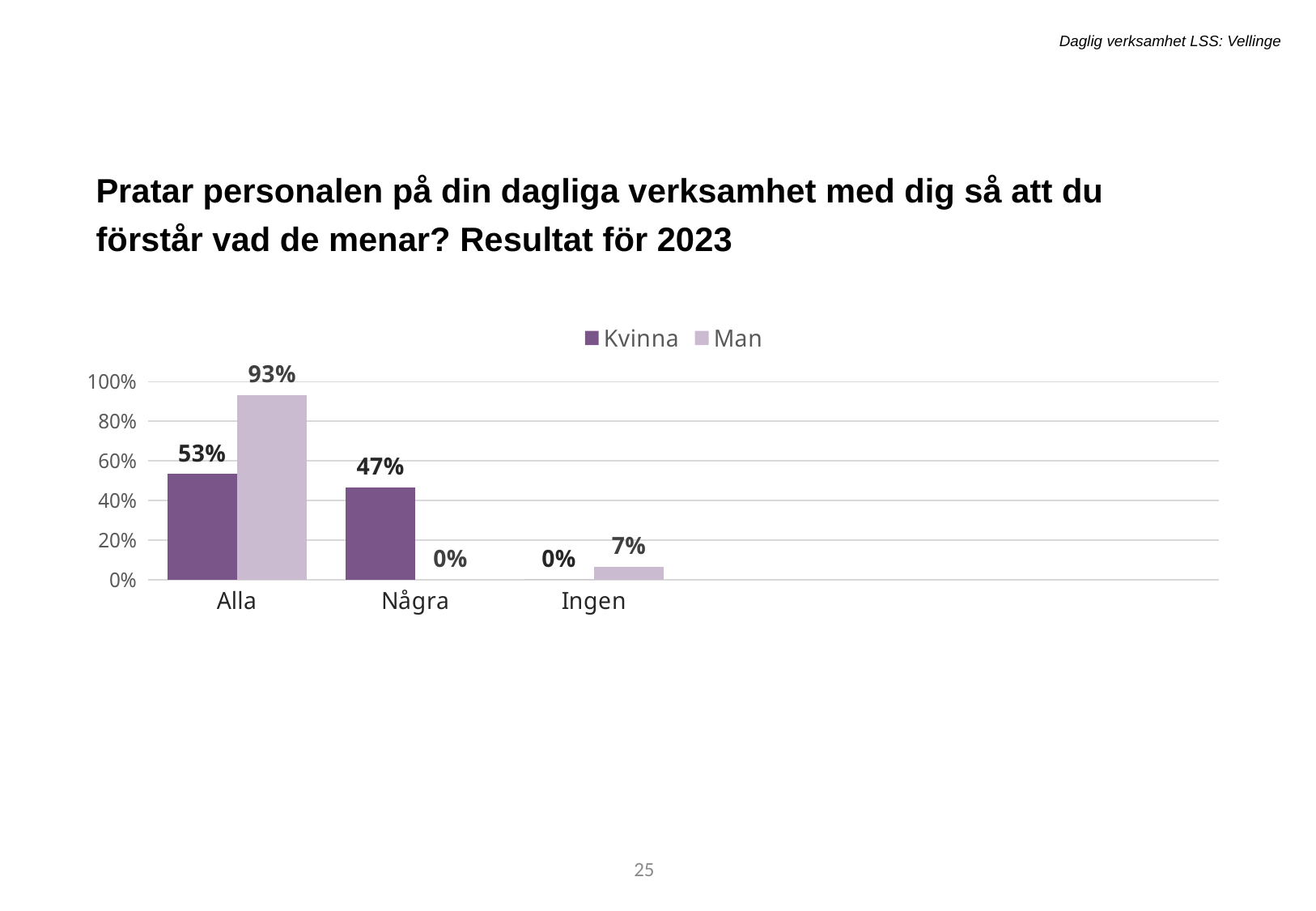
What is the difference between the Man and Kvinna values in the Alla category? 40% How many categories are shown on the x axis? 3 Which category has the highest value for the Man series? Alla What is the value for Man in the Ingen category? 7% Which category has the lowest value for the Kvinna series? Ingen In the Alla category, which series has the larger value, Kvinna or Man? Man What kind of chart is shown on the slide? Bar chart What is the value for Man in the Alla category? 93% How many series does the legend list? 2 What is the value for Kvinna in the Alla category? 53% What is the value for Kvinna in the Några category? 47% What is the value for Man in the Några category? 0%